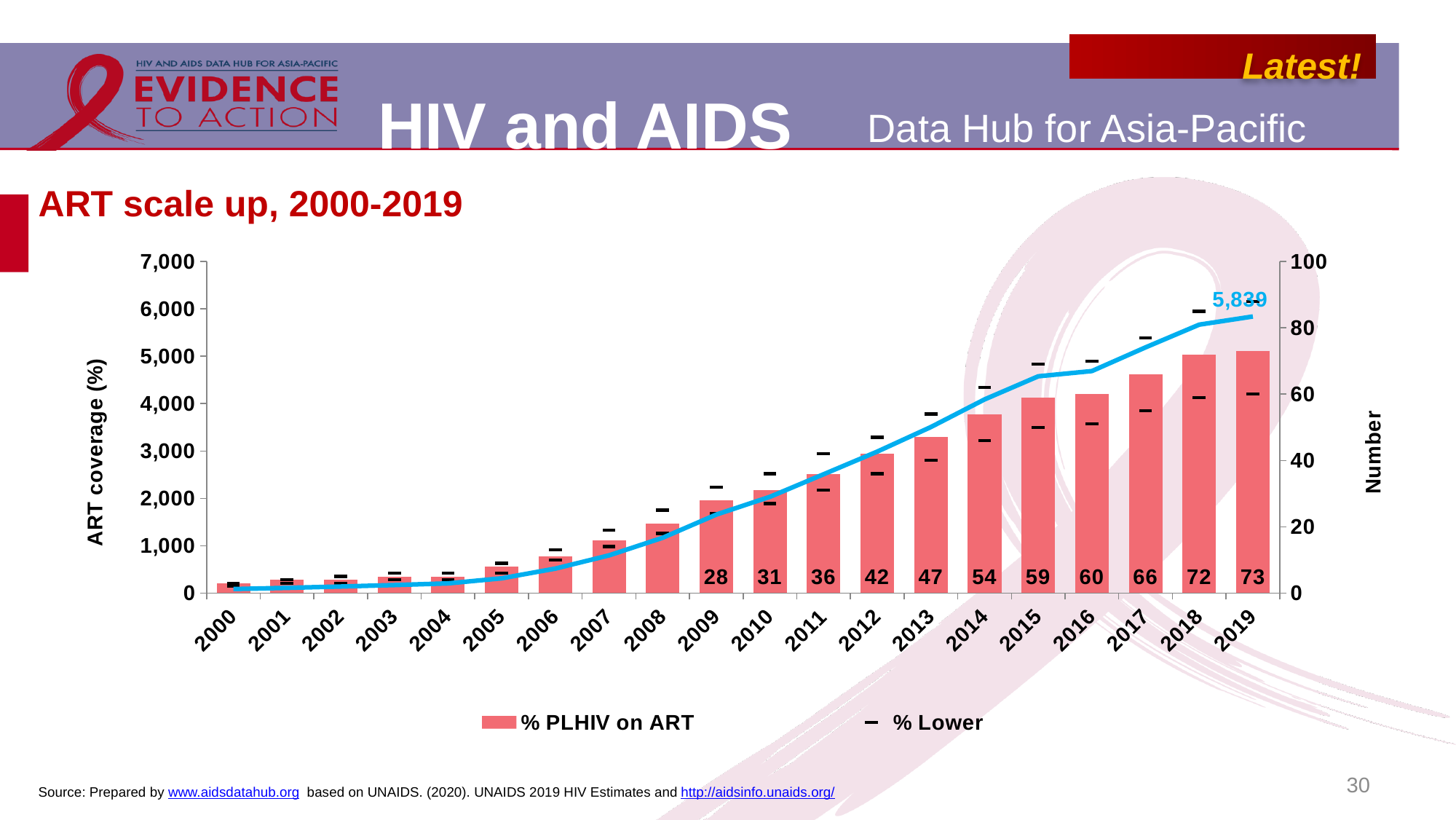
What kind of chart is shown on the slide? Bar chart with a line What is the title of the chart? ART scale up, 2000-2019 Which year has the larger % PLHIV on ART value, 2015 or 2016? 2016 What is the % PLHIV on ART value for 2014? 54 Do the % PLHIV on ART bars rise or fall from 2000 to 2019? Rise How many entries does the legend list? 2 How many years are shown on the x axis? 20 What is the % PLHIV on ART value for 2009? 28 By how much did the % PLHIV on ART value increase from 2009 to 2019? 45 What is the % PLHIV on ART value for 2019? 73 What is the difference between the % PLHIV on ART values for 2018 and 2017? 6 Which year has the highest % PLHIV on ART value? 2019